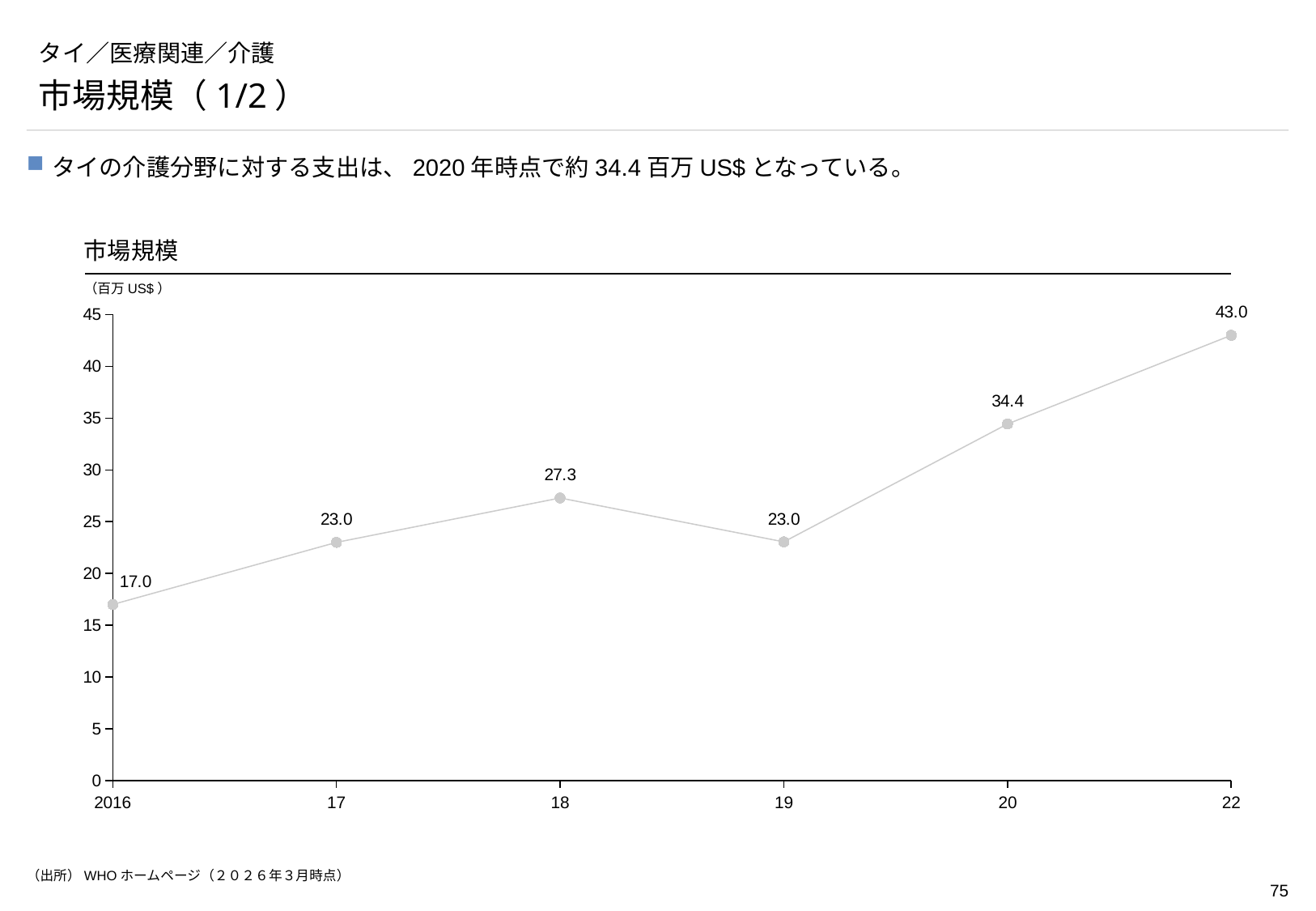
What is the market size value for 2022 (labelled 22)? 43.0 Which year has the lowest market size value? 2016 Which is larger, the value for 18 or the value for 19? 18 What is the market size value for 2016? 17.0 Is the value for 20 greater or less than 30? greater What is the market size value for 2020 (labelled 20)? 34.4 What unit is shown for the chart's values? 百万 US$ How many data points are plotted on the chart? 6 What is the difference between the values for 18 and 17? 4.3 What kind of chart is shown on the slide? line chart What is the difference between the values for 22 and 20? 8.6 Which year has the highest market size value? 22